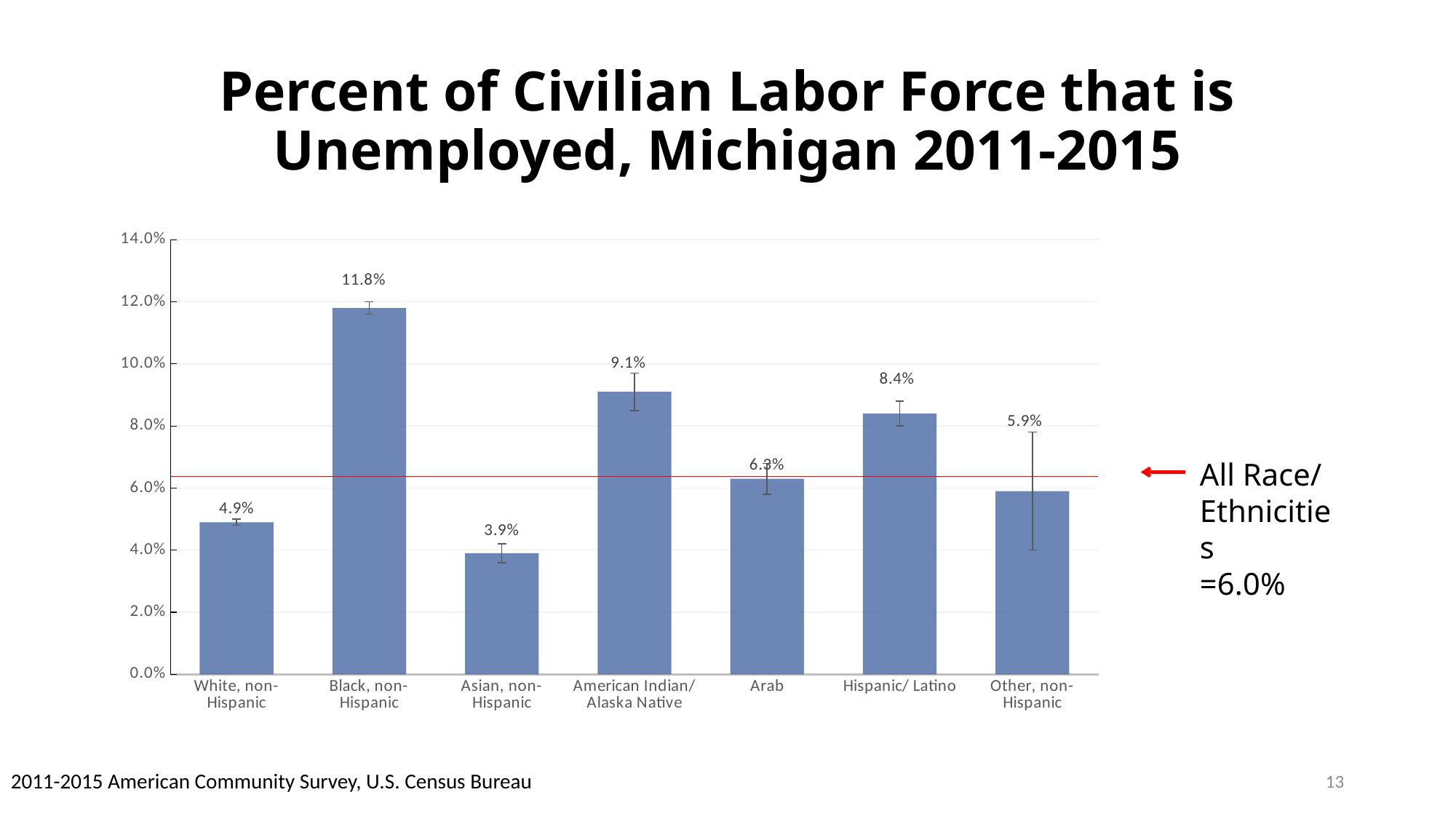
What is the unemployment percentage for American Indian/Alaska Native? 9.1% What is the unemployment percentage for Black, non-Hispanic? 11.8% Is the value for Other, non-Hispanic greater or less than 8.0%? less What is the unemployment percentage for Hispanic/Latino? 8.4% What value does the red horizontal line across the chart represent? All Race/Ethnicities = 6.0% What is the difference between the unemployment percentages for Black, non-Hispanic and White, non-Hispanic? 6.9% What kind of chart is shown on the slide? Bar chart What is the unemployment percentage for White, non-Hispanic? 4.9% How many race/ethnicity categories are shown in the chart? 7 Which race/ethnicity group has the highest unemployment percentage? Black, non-Hispanic Which race/ethnicity group has the lowest unemployment percentage? Asian, non-Hispanic Which has a higher unemployment percentage, American Indian/Alaska Native or Hispanic/Latino? American Indian/Alaska Native